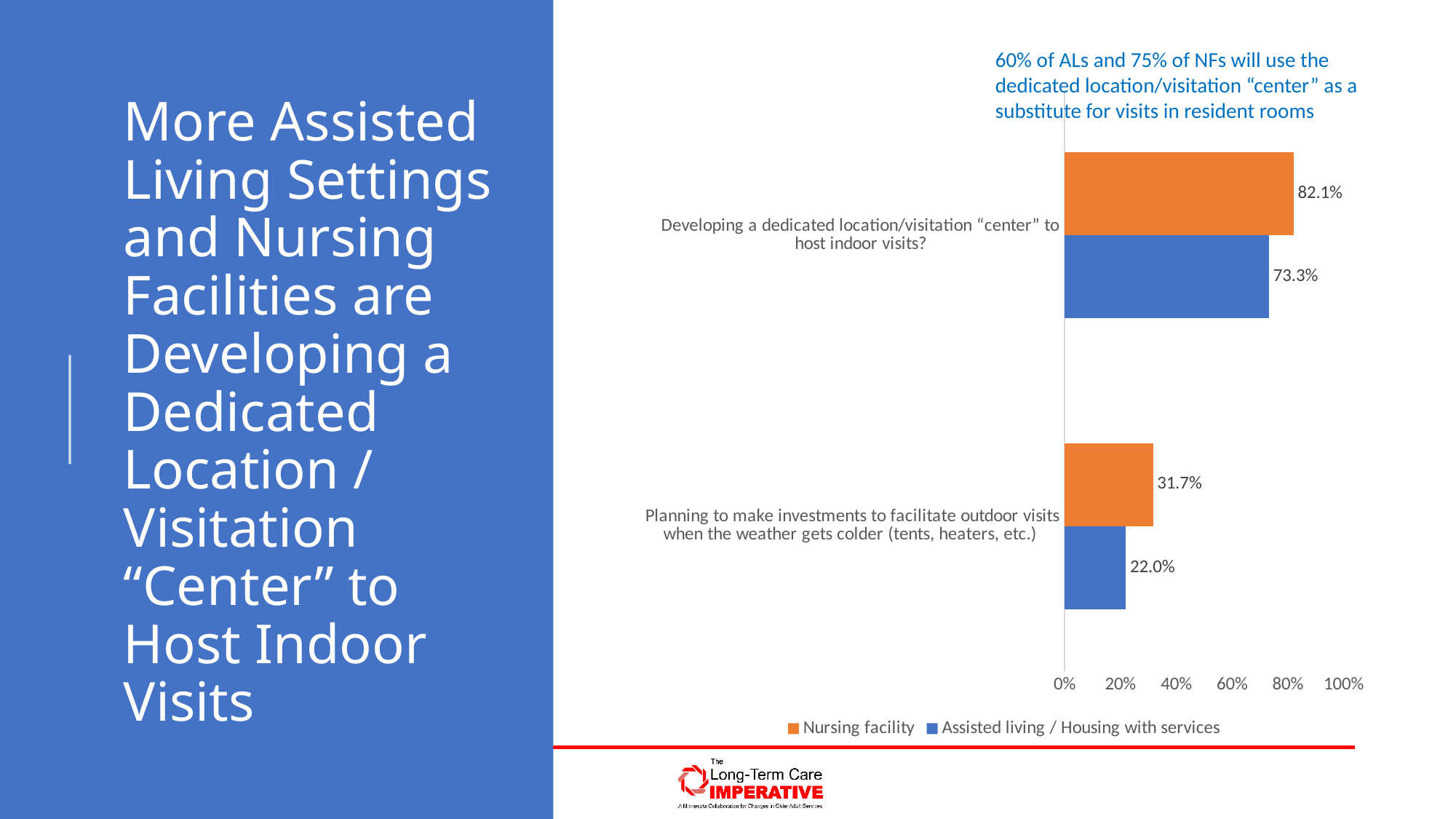
How many series does the chart legend list? 2 What percentage of assisted living / housing with services settings are planning to make investments to facilitate outdoor visits when the weather gets colder? 22.0% Which bar in the chart has the lowest value? Assisted living / Housing with services, planning to make investments to facilitate outdoor visits (22.0%) How many categories are shown on the chart? 2 What percentage of nursing facilities are planning to make investments to facilitate outdoor visits when the weather gets colder? 31.7% Which bar in the chart has the highest value? Nursing facility, developing a dedicated location/visitation "center" (82.1%) What is the difference between the nursing facility and assisted living values for planning investments to facilitate outdoor visits in colder weather? 9.7% What is the difference between the nursing facility and assisted living values for developing a dedicated location/visitation "center"? 8.8% What type of chart is shown on the slide? Bar chart Which series has the higher value for developing a dedicated location/visitation "center" to host indoor visits? Nursing facility What percentage of assisted living / housing with services settings are developing a dedicated location/visitation "center" to host indoor visits? 73.3% What percentage of nursing facilities are developing a dedicated location/visitation "center" to host indoor visits? 82.1%